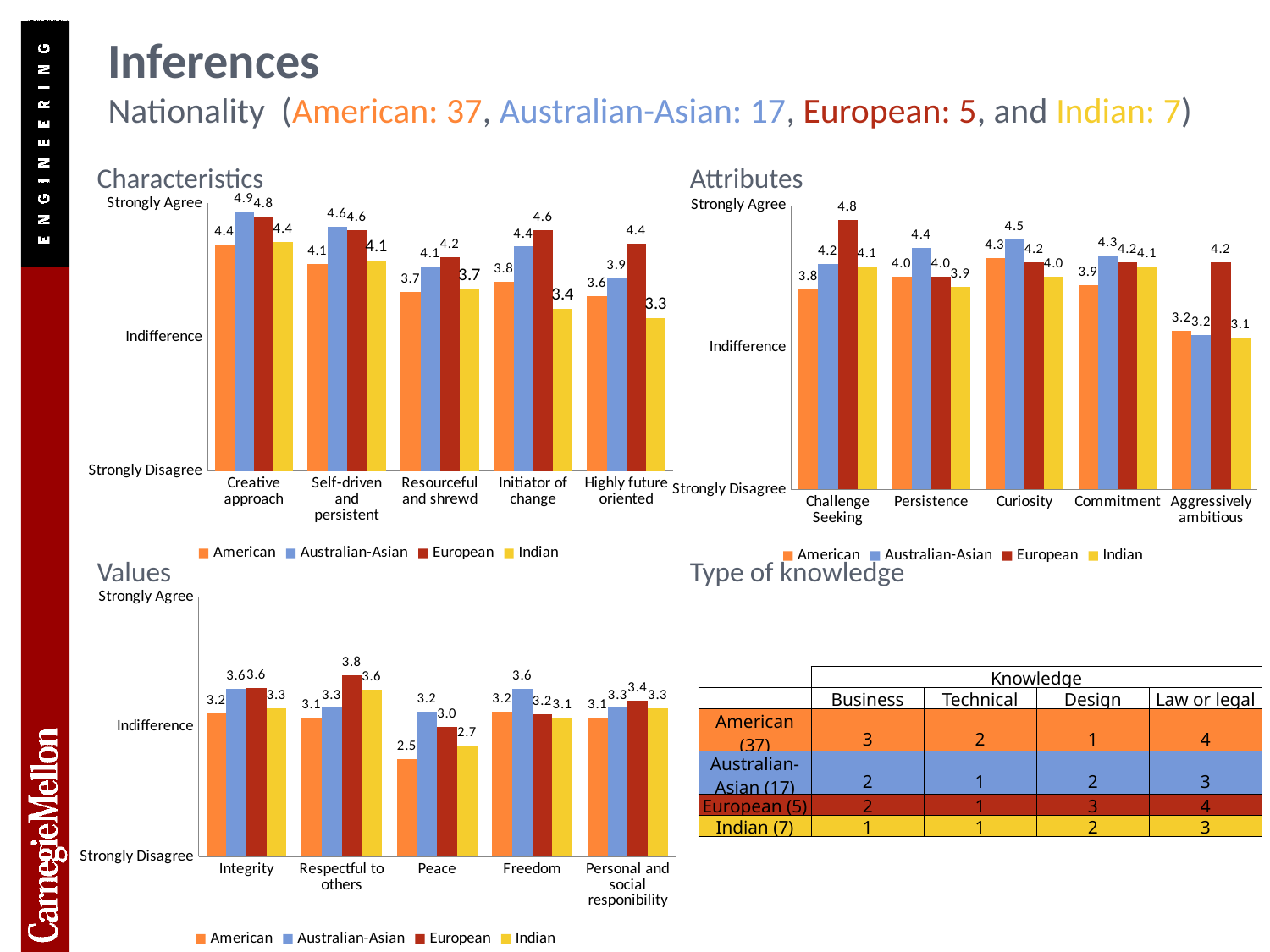
In the Characteristics chart, what is the value for Indian on Highly future oriented? 3.3 In the Values chart, which category has the highest European value? Respectful to others In the Characteristics chart, which category has the highest European value? Creative approach In the Characteristics chart, what is the value for Australian-Asian on Creative approach? 4.9 In the Attributes chart, what is the value for European on Challenge Seeking? 4.8 In the Values chart, what is the difference between the Australian-Asian and American values for Freedom? 0.4 In the Attributes chart, which category has the lowest Indian value? Aggressively ambitious In the Characteristics chart, what is the difference between the European and Indian values for Initiator of change? 1.2 In the Attributes chart, which is larger for Persistence: the Australian-Asian value or the American value? Australian-Asian How many series does the legend of the Values chart list? 4 In the Values chart, what is the value for American on Peace? 2.5 What type of chart is the Attributes chart? Bar chart